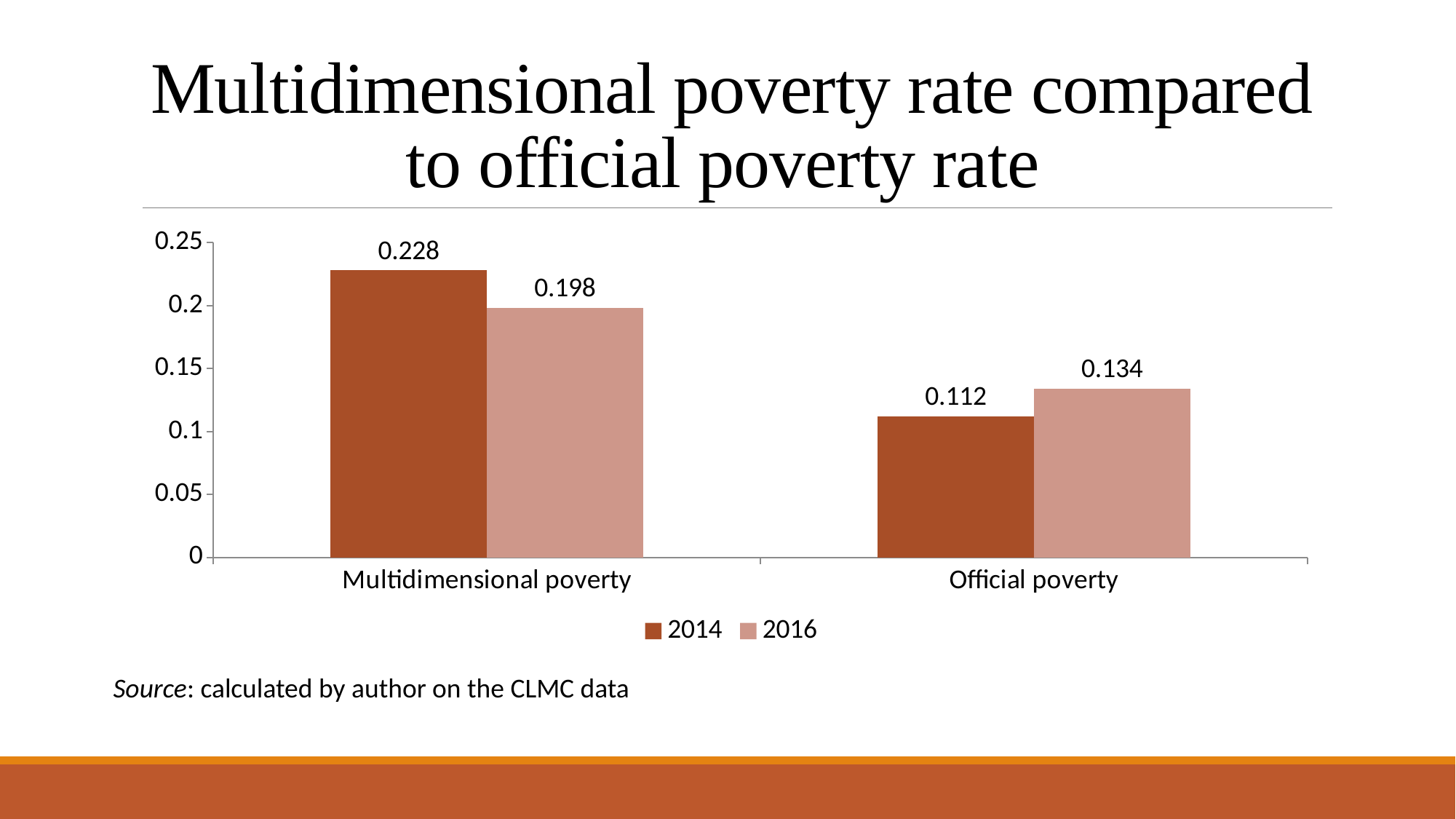
Which bar has the highest value on the chart? Multidimensional poverty, 2014 What kind of chart is shown on the slide? Bar chart What is the multidimensional poverty rate for 2016? 0.198 How many series does the legend list? 2 Which bar has the lowest value on the chart? Official poverty, 2014 What is the official poverty rate for 2016? 0.134 What is the multidimensional poverty rate for 2014? 0.228 What is the difference between the multidimensional poverty rate in 2014 and in 2016? 0.030 What is the difference between the official poverty rate in 2016 and in 2014? 0.022 Which is larger in 2016: the multidimensional poverty rate or the official poverty rate? Multidimensional poverty What is the official poverty rate for 2014? 0.112 Which years are listed in the chart legend? 2014 and 2016